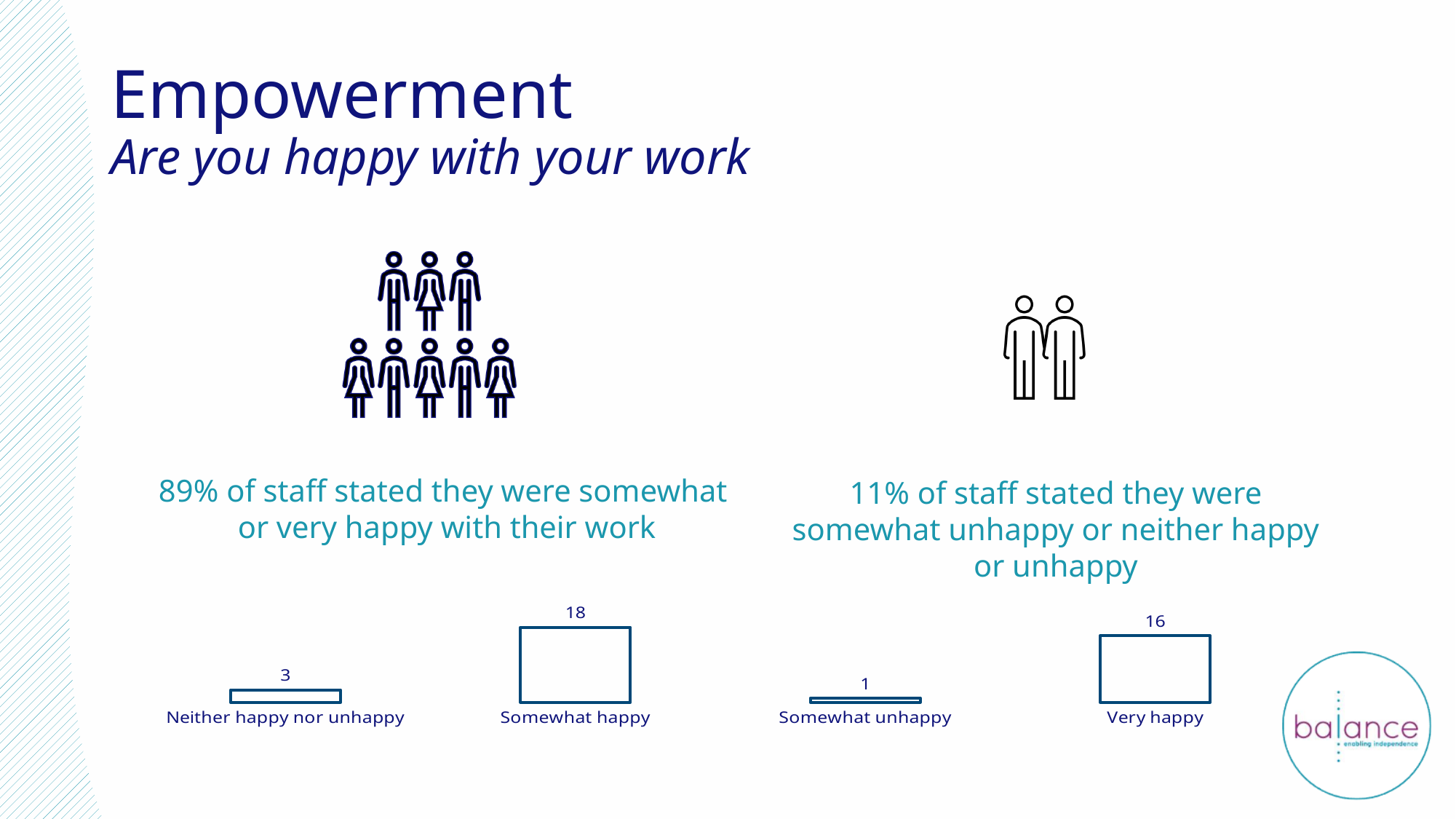
Which category has the lowest value? Somewhat unhappy What is the difference between the values for Neither happy nor unhappy and Somewhat unhappy? 2 What is the value for Very happy? 16 What is the total of all four category values in the chart? 38 What kind of chart is shown at the bottom of the slide? Bar chart What is the value for Somewhat happy? 18 Which is larger, the value for Very happy or the value for Neither happy nor unhappy? Very happy What is the value for Somewhat unhappy? 1 How many categories are shown in the chart? 4 What is the value for Neither happy nor unhappy? 3 What is the difference between the values for Somewhat happy and Very happy? 2 Which category has the highest value? Somewhat happy